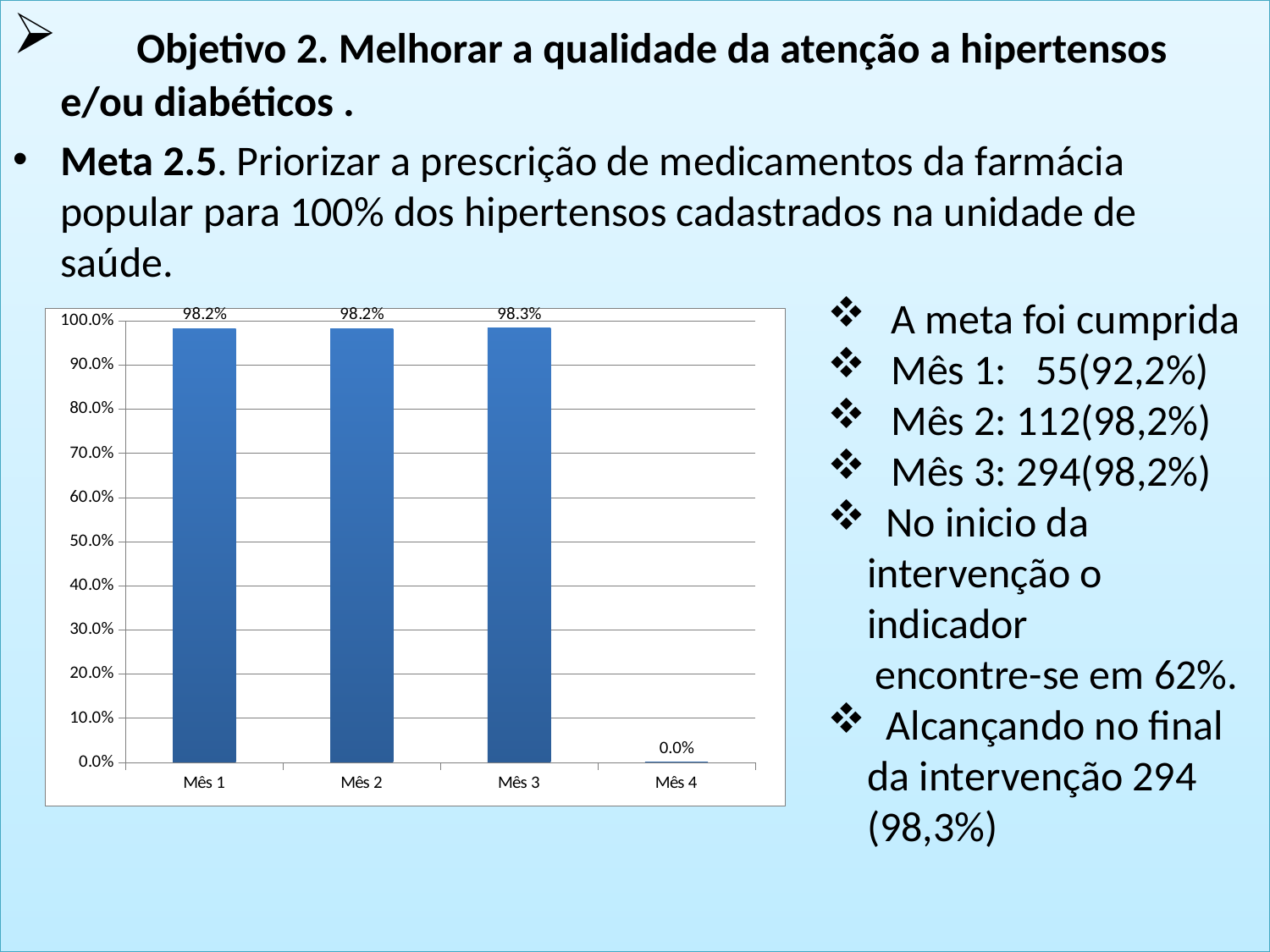
What is the value shown for Mês 4? 0.0% What kind of chart is shown on the slide? bar chart How many categories are shown on the x axis? 4 What is the value shown for Mês 2? 98.2% Is the value for Mês 2 greater or less than 90%? greater What is the value shown for Mês 3? 98.3% What is the difference between the values for Mês 3 and Mês 1? 0.1% What is the highest tick value shown on the y axis? 100.0% What is the difference between the values for Mês 3 and Mês 4? 98.3% Which is larger, the value for Mês 1 or the value for Mês 4? Mês 1 What is the value shown for Mês 1? 98.2% Which category has the lowest value? Mês 4